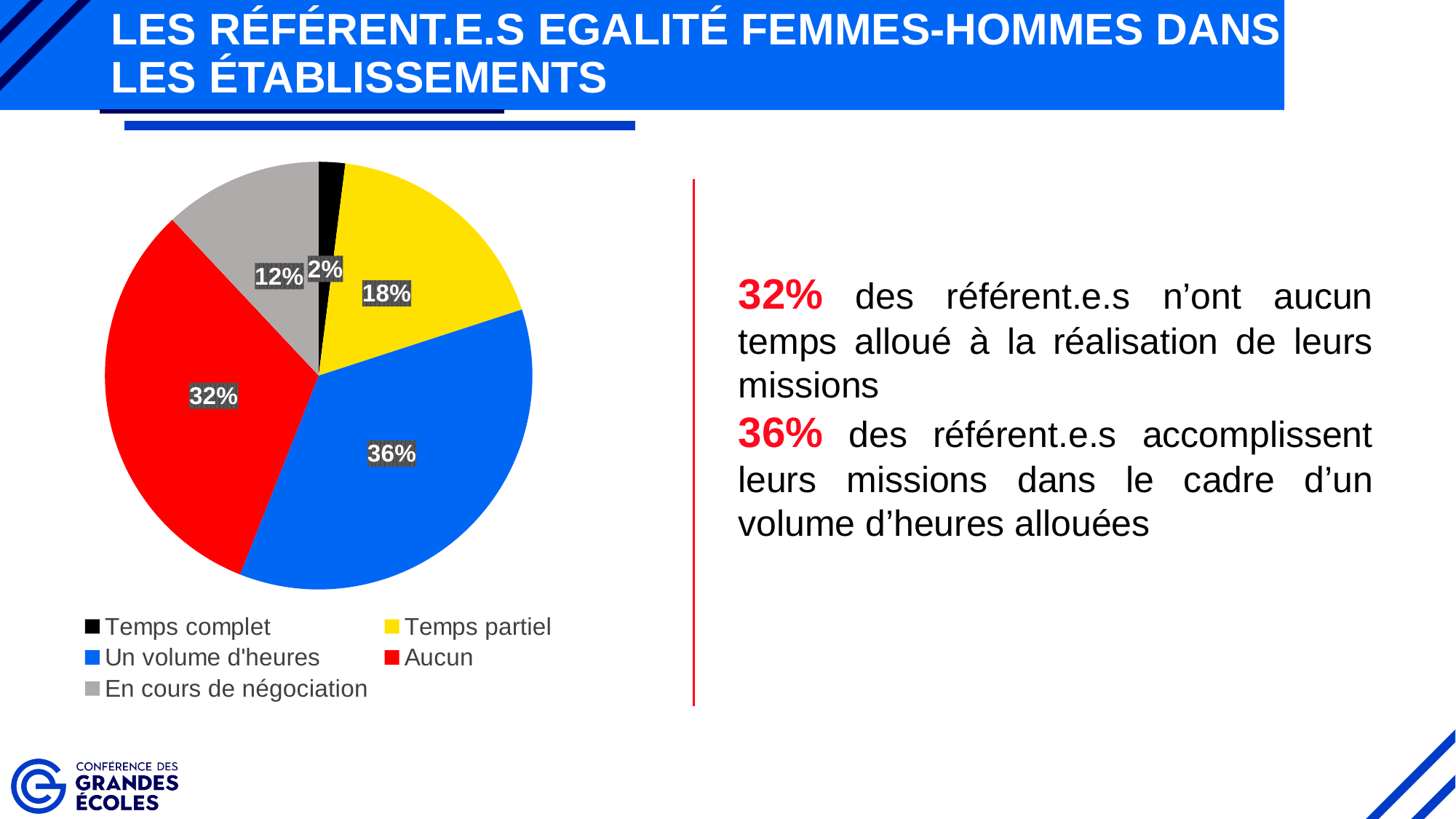
Which category has the largest share of the pie? Un volume d'heures What percentage of the pie corresponds to "Aucun"? 32% Which is larger: the share for "Temps partiel" or the share for "En cours de négociation"? Temps partiel What is the difference in percentage points between "Un volume d'heures" and "Aucun"? 4 What colour is the slice for "Aucun"? Red What percentage of the pie corresponds to "Temps complet"? 2% What percentage of the pie corresponds to "En cours de négociation"? 12% What percentage of the pie corresponds to "Un volume d'heures"? 36% Which category has the smallest share of the pie? Temps complet How many categories does the pie chart have? 5 What percentage of the pie corresponds to "Temps partiel"? 18% What type of chart is shown on the slide? Pie chart